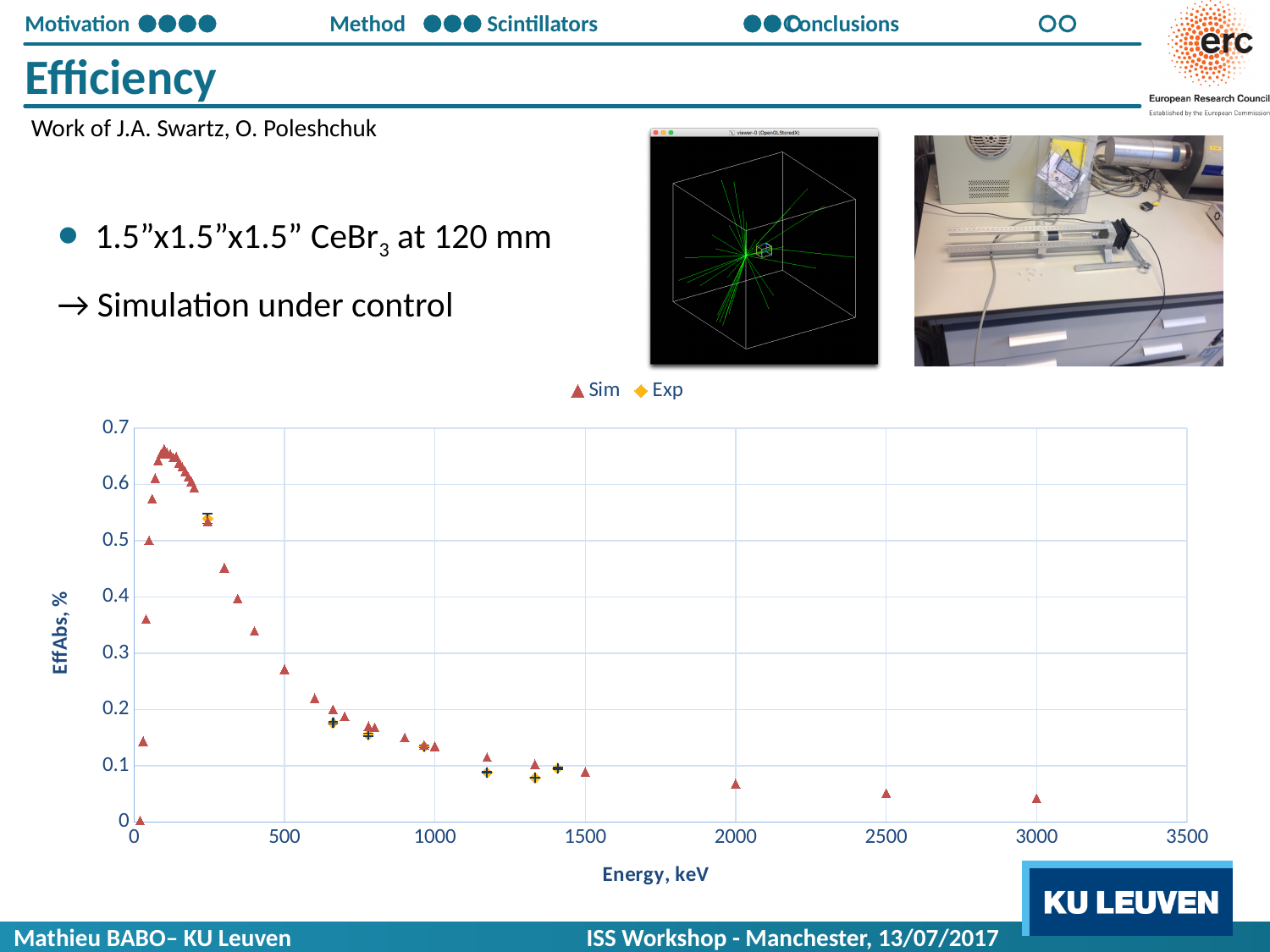
Is the Exp value near 250 keV greater or less than 0.5? greater Which is larger, the Sim value at 2000 keV or the Sim value at 3000 keV? 2000 keV Is the highest Sim value on the chart greater or less than 0.6? greater Which is larger, the Sim value at 500 keV or the Sim value at 1000 keV? 500 keV Is the Sim value at 500 keV greater or less than 0.2? greater What kind of chart is shown on the slide? scatter chart Beyond 500 keV, do the Sim values rise or fall as energy increases? fall What are the two series named in the chart legend? Sim and Exp What is the label of the x axis of the chart? Energy, keV How many series does the chart legend list? 2